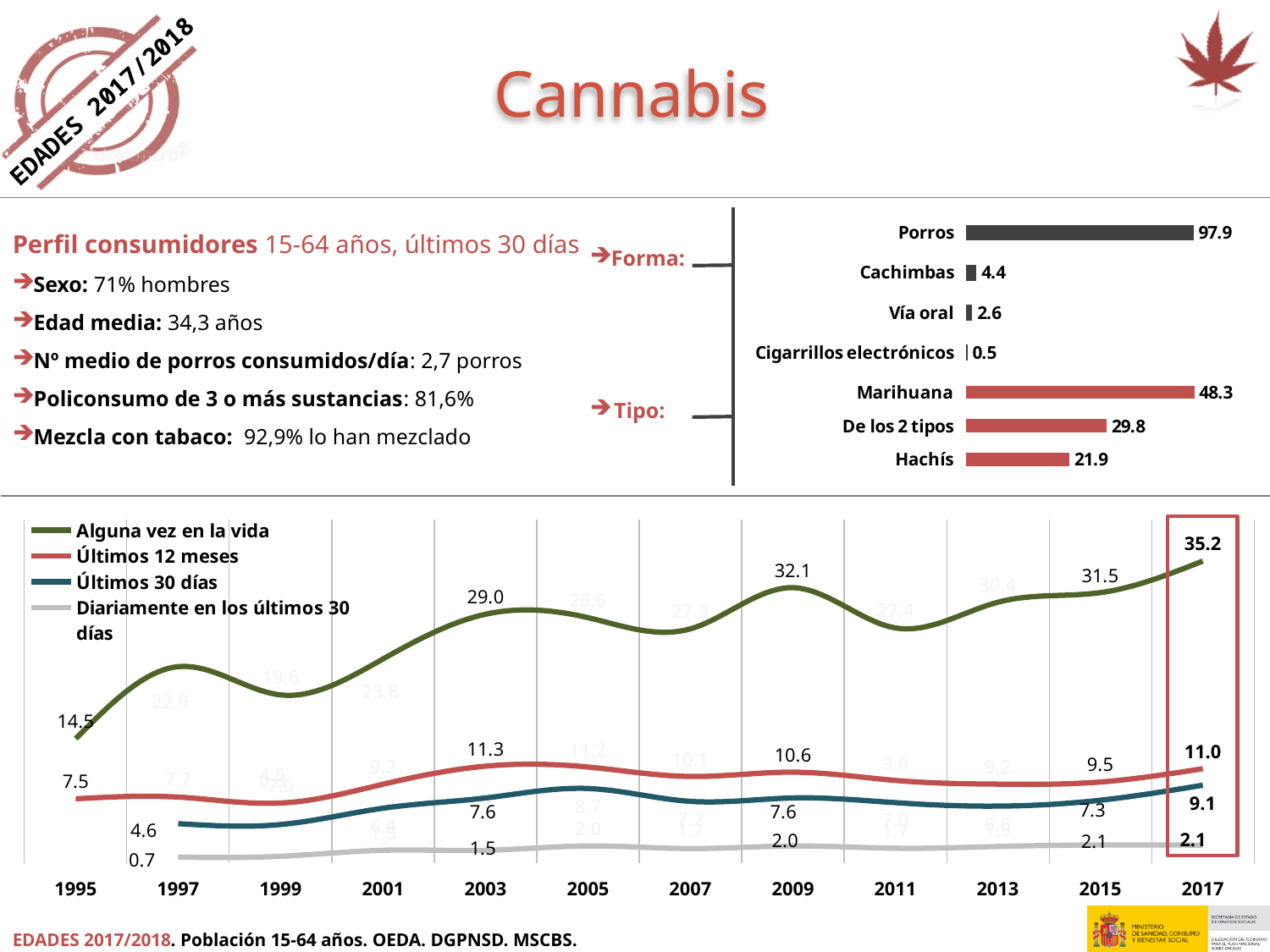
In the bar chart at the top right, which category has the lowest value? Cigarrillos electrónicos What type of chart is shown at the bottom of the slide? Line chart In the bar chart at the top right, how many categories are shown? 7 In the line chart at the bottom, what is the value of 'Alguna vez en la vida' in 2017? 35.2 In the line chart at the bottom, what is the value of 'Alguna vez en la vida' in 2009? 32.1 In the bar chart at the top right, what is the value for Marihuana? 48.3 In the line chart at the bottom, what is the difference between the 'Últimos 12 meses' values in 2017 and 2015? 1.5 In the line chart at the bottom, what is the value of 'Últimos 30 días' in 2017? 9.1 In the line chart at the bottom, how many series does the legend list? 4 In the bar chart at the top right, what is the value for Porros? 97.9 In the bar chart at the top right, what is the difference between the values for Marihuana and Hachís? 26.4 In the bar chart at the top right, which is larger, the value for Cachimbas or the value for Vía oral? Cachimbas